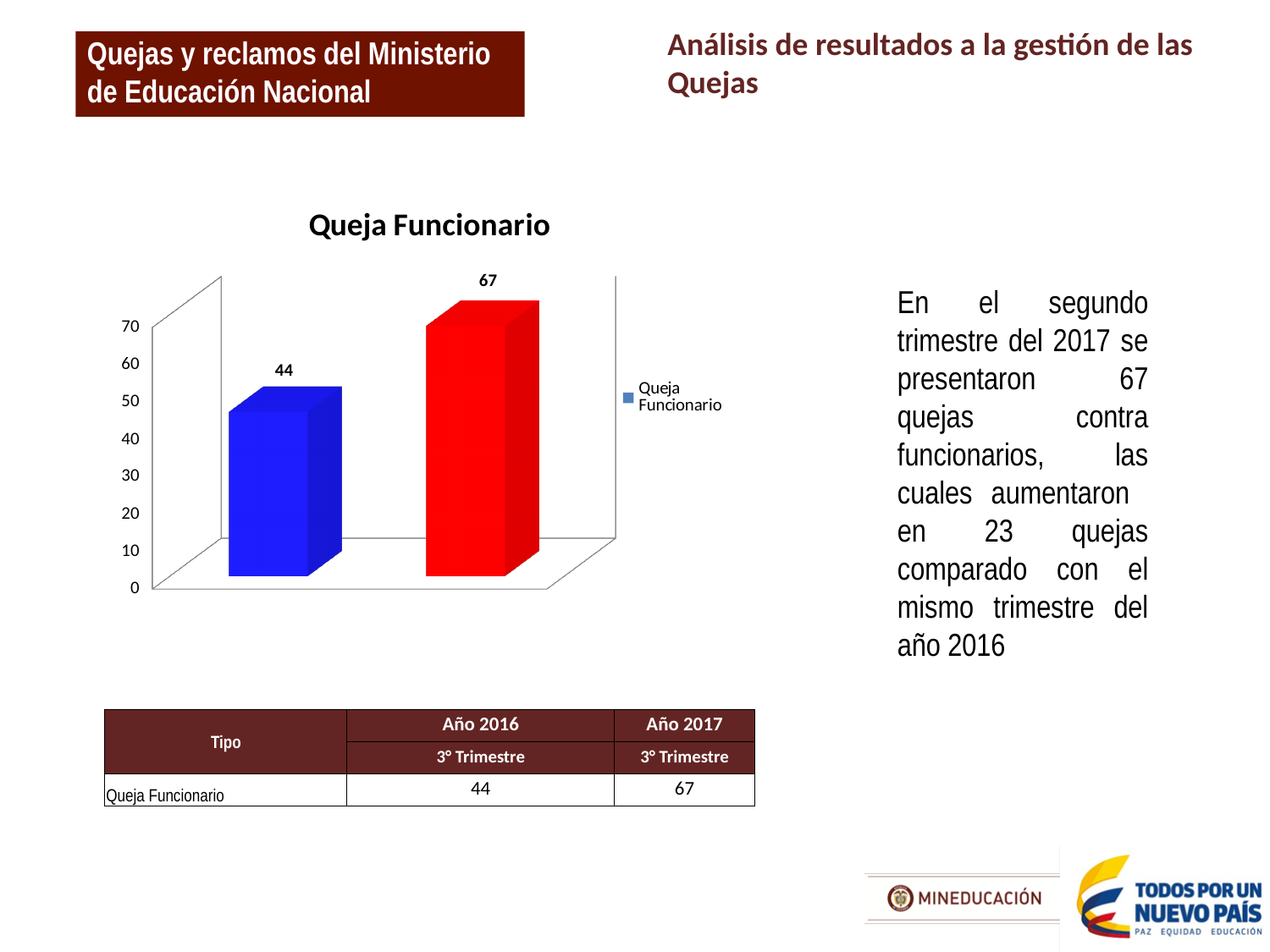
Is the value of the blue bar greater or less than 50? less Which bar has the lowest value, the blue one or the red one? blue What is the difference between the red bar (67) and the blue bar (44)? 23 How many series does the chart legend list? 1 What is the title of the chart? Queja Funcionario What is the value of the red (right) bar in the chart? 67 What type of chart is shown on the slide? bar chart Do the values rise or fall from the left bar to the right bar? rise How many bars are plotted in the chart? 2 Which bar has the highest value, the blue one or the red one? red What is the value of the blue (left) bar in the chart? 44 What is the legend entry shown in the chart? Queja Funcionario